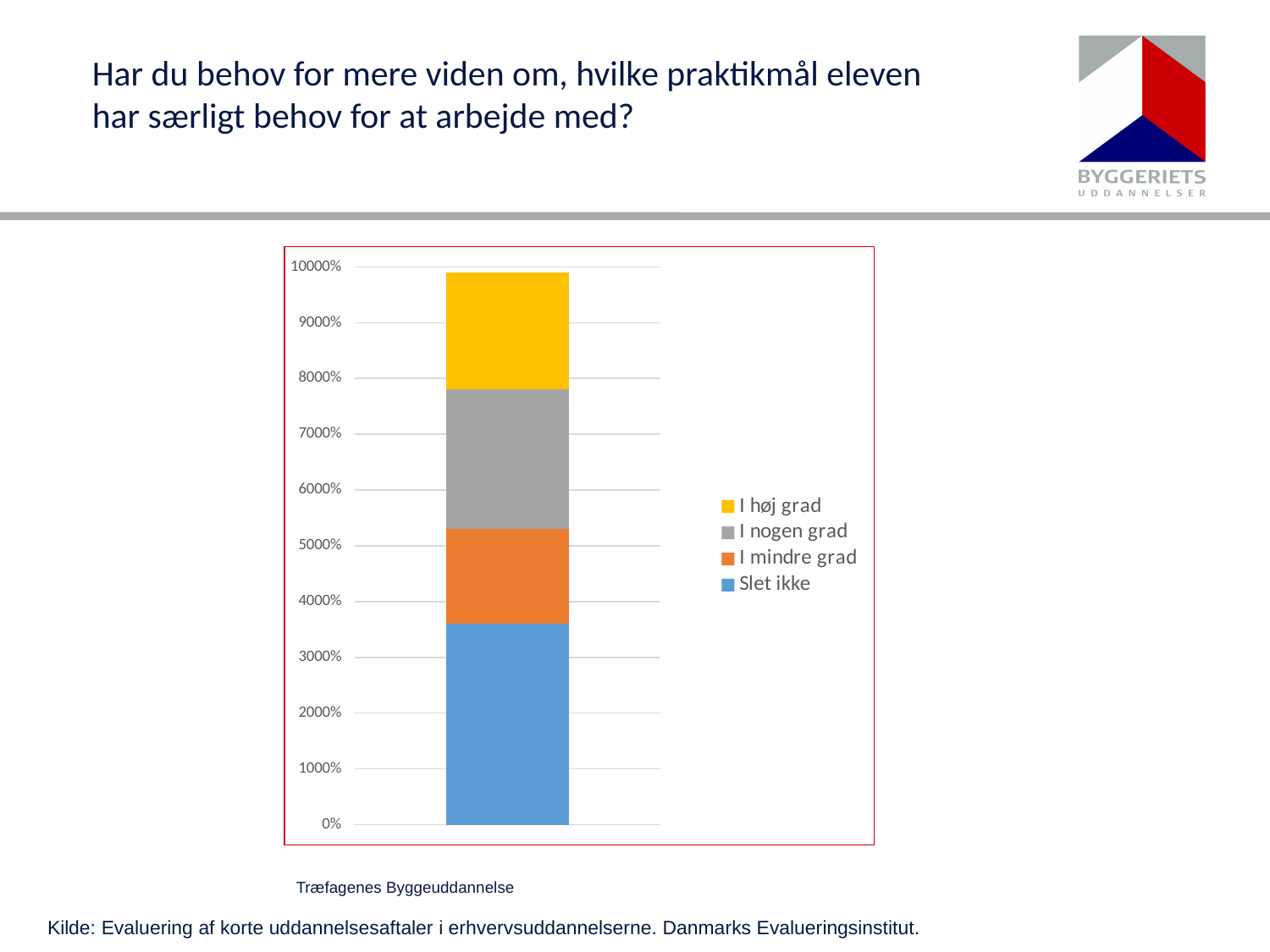
How many bars are plotted in the chart? 1 Which series forms the top segment of the stacked bar? I høj grad Which series forms the bottom segment of the stacked bar? Slet ikke Which series has the largest segment in the stacked bar? Slet ikke Which legend entry is shown in yellow? I høj grad Which legend entry is shown in blue? Slet ikke Which segment is larger, I nogen grad or I mindre grad? I nogen grad Is the total height of the stacked bar greater or less than 9000%? greater How many series does the legend list? 4 Which series has the smallest segment in the stacked bar? I mindre grad Is the segment for Slet ikke greater or less than 3000%? greater What kind of chart is shown on the slide? stacked bar chart